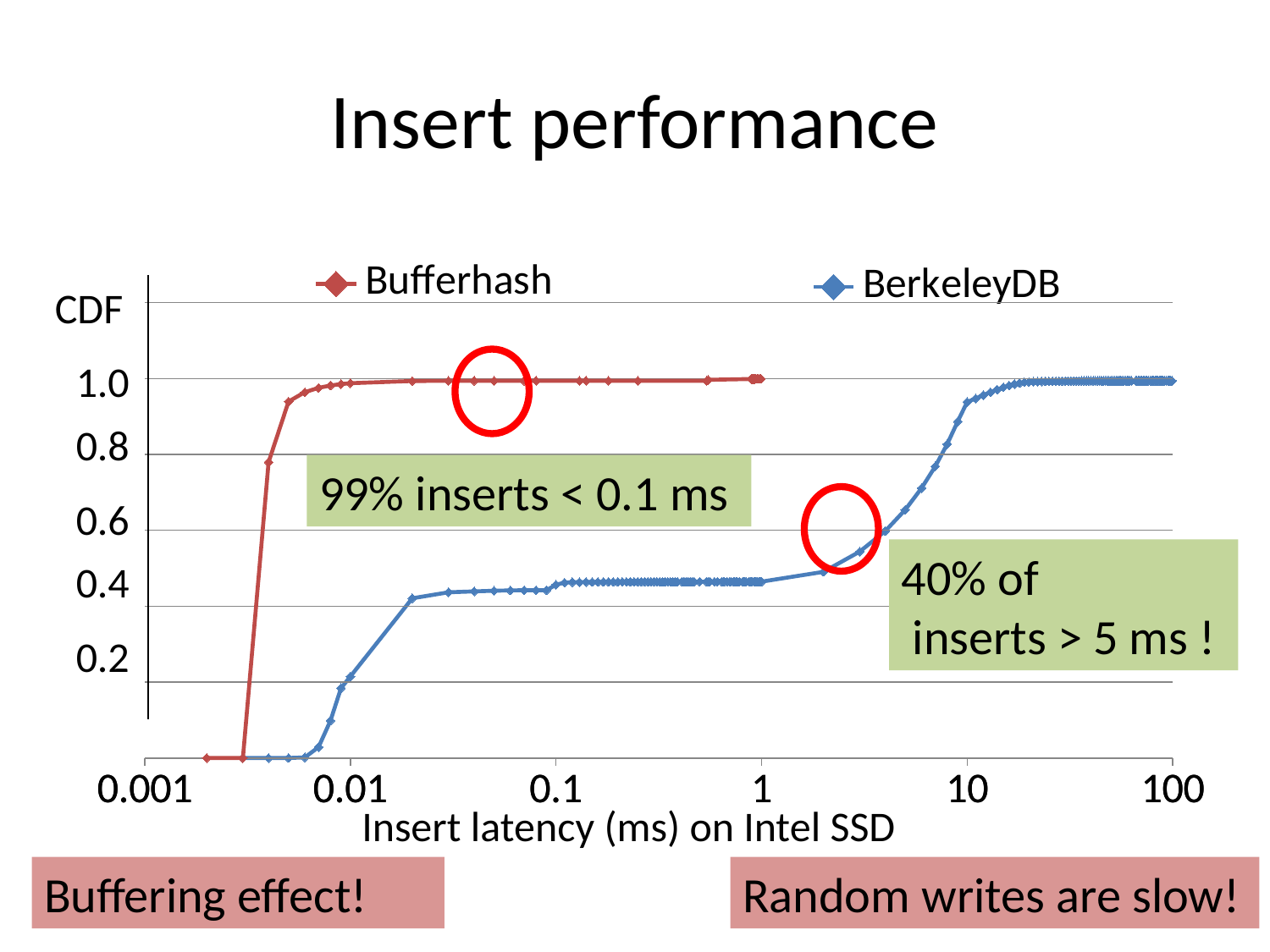
At an insert latency of 0.1 ms, which series has the higher CDF value, Bufferhash or BerkeleyDB? Bufferhash Is the CDF value for BerkeleyDB at 10 ms greater or less than 0.8? greater Is the CDF value for Bufferhash at 0.01 ms greater or less than 0.8? greater According to the annotation on the chart, what percentage of Bufferhash inserts take less than 0.1 ms? 99% What kind of chart is shown on the slide? Line chart How many series does the legend list? 2 What is the label of the x axis? Insert latency (ms) on Intel SSD Which series reaches a CDF of 1.0 at a lower insert latency, Bufferhash or BerkeleyDB? Bufferhash Does the BerkeleyDB curve rise or fall as insert latency increases along the x axis? rise Is the CDF value for BerkeleyDB at 1 ms greater or less than 0.6? less What are the two series named in the legend? Bufferhash and BerkeleyDB